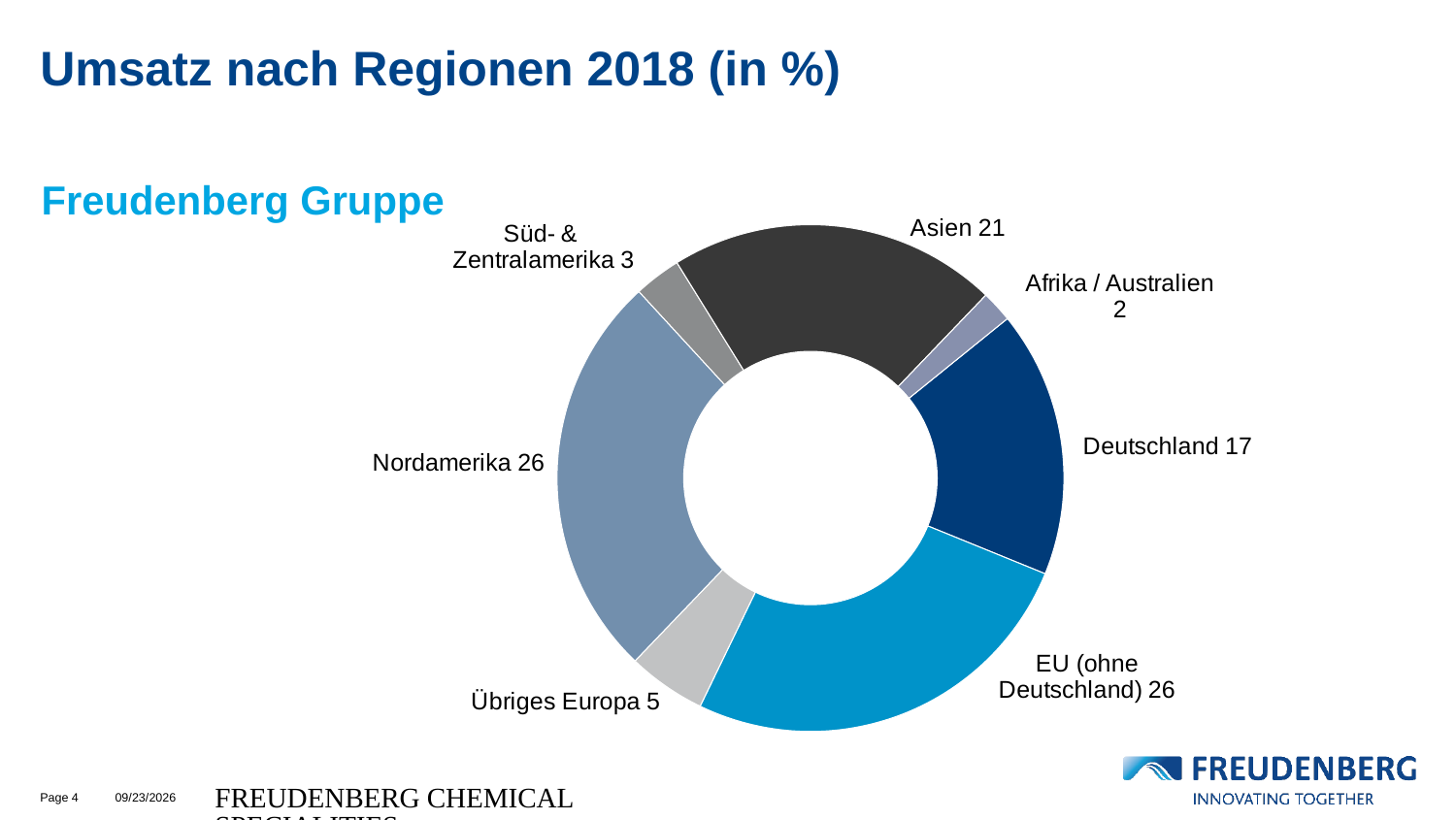
What is the value for Afrika / Australien? 2 What is the value for Süd- & Zentralamerika? 3 What is the difference between the values for Asien and Übriges Europa? 16 How many regions are shown in the chart? 7 What kind of chart is shown on the slide? doughnut chart What is the value for Asien? 21 Which region has the smallest share? Afrika / Australien What is the value for Übriges Europa? 5 What is the difference between the values for Nordamerika and Deutschland? 9 What is the title of the slide? Umsatz nach Regionen 2018 (in %) Which is larger, the value for Asien or the value for Deutschland? Asien What is the value for Deutschland? 17